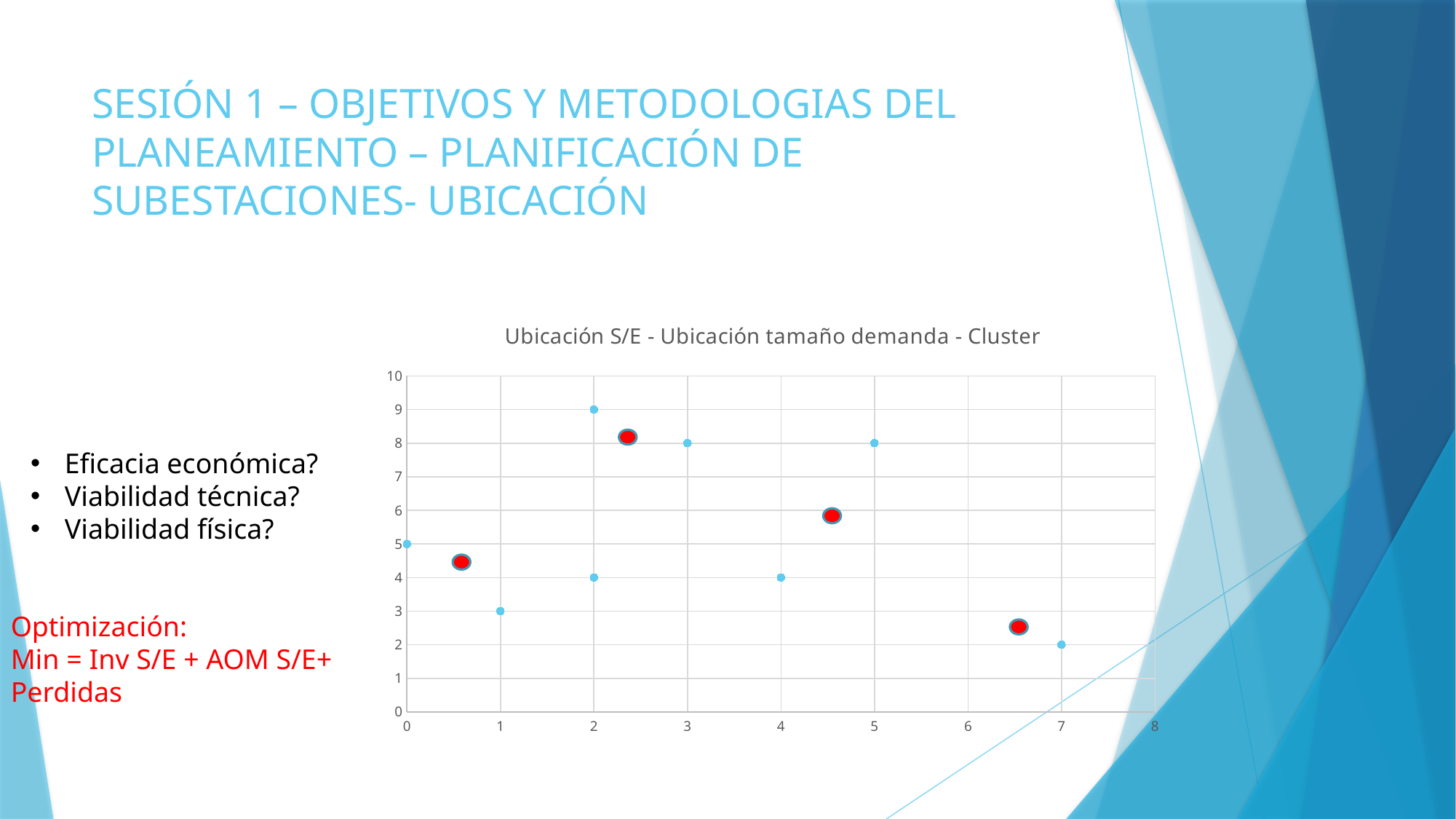
What is the maximum value shown on the vertical axis? 10 What is the y value of the blue point at x = 0? 5 What is the y value of the blue point at x = 1? 3 What is the title of the chart? Ubicación S/E - Ubicación tamaño demanda - Cluster What kind of chart is shown on the slide? Scatter chart Which has the larger y value: the blue point at x = 3 or the blue point at x = 4? The blue point at x = 3 What is the y value of the highest blue point on the chart? 9 What is the y value of the lowest blue point on the chart? 2 How many large red markers are plotted on the chart? 4 Is the y value of the red marker near x = 2.4 greater or less than 7? greater Is the y value of the red marker near x = 6.5 greater or less than 3? less How many small blue points are plotted on the chart? 8